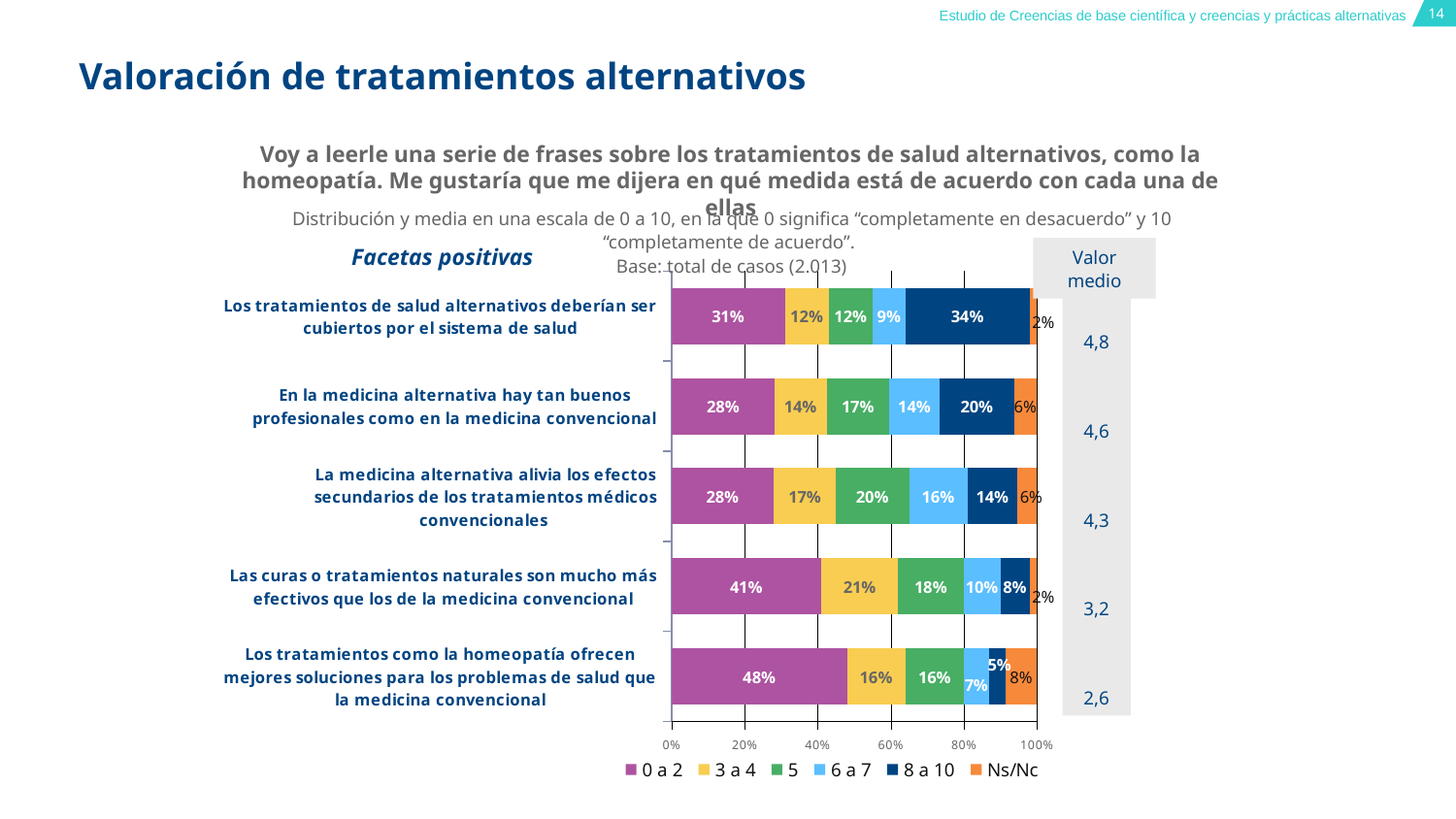
Which statement has the lowest share of 8 a 10 responses? Los tratamientos como la homeopatía ofrecen mejores soluciones para los problemas de salud que la medicina convencional Which statement has the highest share of 0 a 2 responses? Los tratamientos como la homeopatía ofrecen mejores soluciones para los problemas de salud que la medicina convencional How many statements are shown in the chart? 5 What percentage of respondents gave a score of 0 a 2 to the statement "Los tratamientos como la homeopatía ofrecen mejores soluciones para los problemas de salud que la medicina convencional"? 48% Which statement has a larger 8 a 10 share: "Los tratamientos de salud alternativos deberían ser cubiertos por el sistema de salud" or "En la medicina alternativa hay tan buenos profesionales como en la medicina convencional"? Los tratamientos de salud alternativos deberían ser cubiertos por el sistema de salud What is the Ns/Nc share for the statement "Los tratamientos como la homeopatía ofrecen mejores soluciones para los problemas de salud que la medicina convencional"? 8% How many series does the legend list? 6 What is the difference in percentage points between the 0 a 2 share for the homeopatía statement and the 0 a 2 share for "Las curas o tratamientos naturales son mucho más efectivos que los de la medicina convencional"? 7 percentage points What kind of chart is shown on the slide? Stacked bar chart What is the Valor medio for the statement "Las curas o tratamientos naturales son mucho más efectivos que los de la medicina convencional"? 3,2 What is the heading shown above the list of statements in the chart? Facetas positivas What percentage gave a score of 8 a 10 to the statement "Los tratamientos de salud alternativos deberían ser cubiertos por el sistema de salud"? 34%